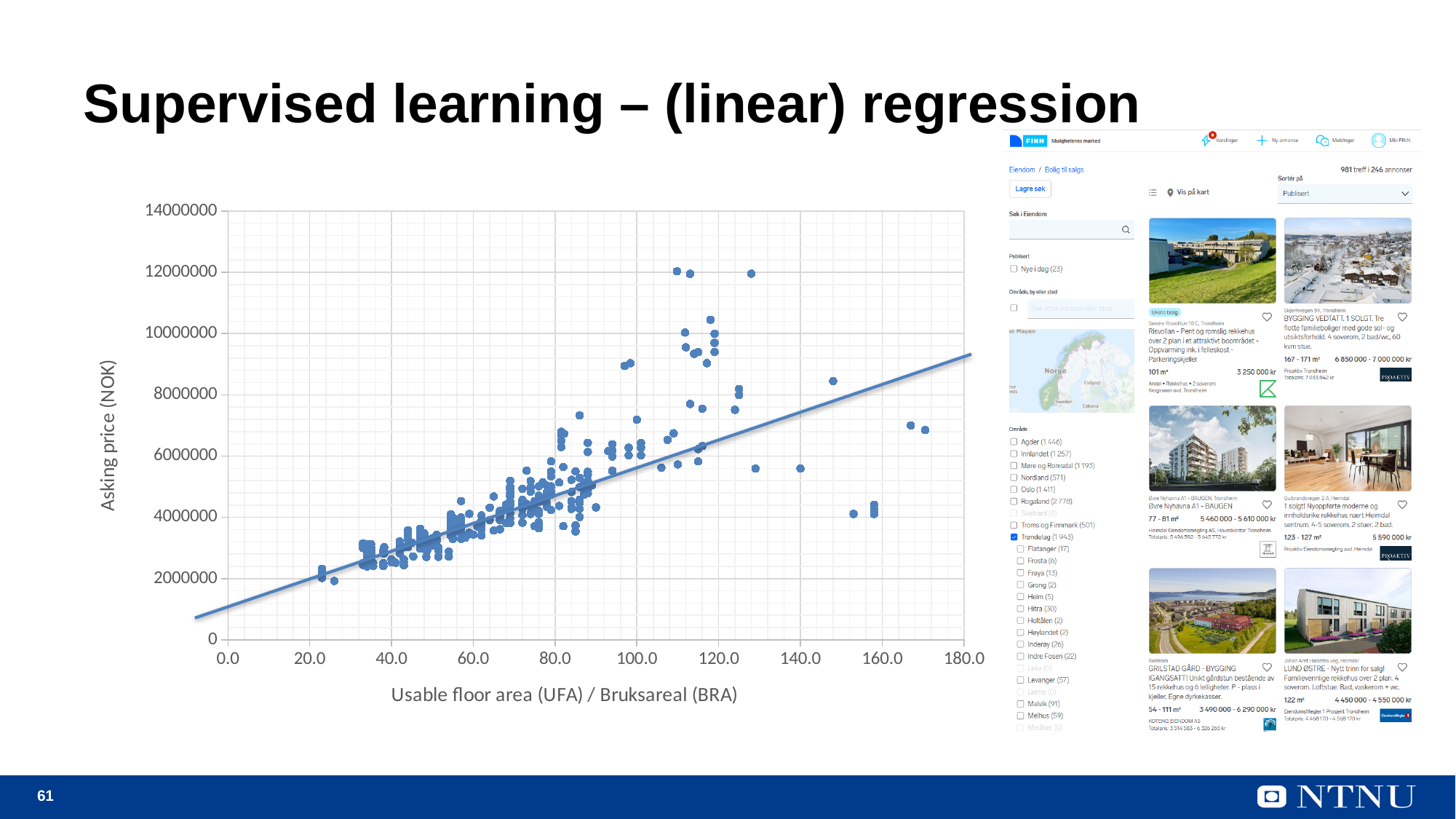
Is the asking price of the point with the smallest usable floor area greater or less than 4000000? less What is the label of the x axis of the chart? Usable floor area (UFA) / Bruksareal (BRA) What kind of chart is shown on the slide? Scatter plot Does the fitted regression line slope upward or downward across the chart? Upward Is the largest usable floor area plotted in the chart greater or less than 160.0? greater Is the asking price of the point with the largest usable floor area greater or less than 8000000? less Does the asking price generally rise or fall as usable floor area increases along the x axis? Rise What is the label of the y axis of the chart? Asking price (NOK)